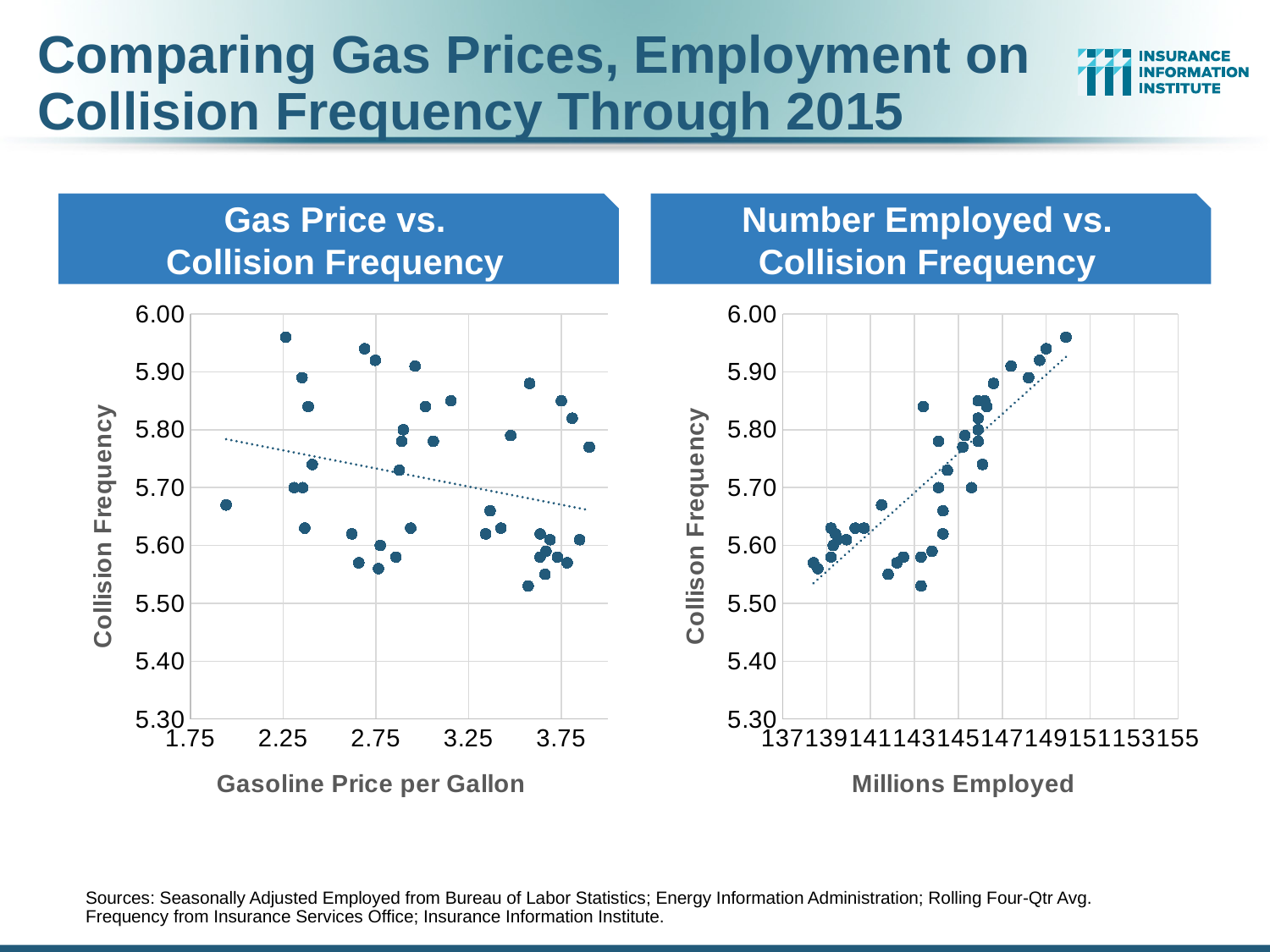
What is the x-axis title of the "Number Employed vs. Collision Frequency" chart? Millions Employed In the "Gas Price vs. Collision Frequency" chart, is the collision frequency for the point with the lowest gasoline price greater or less than 5.70? less In the "Gas Price vs. Collision Frequency" chart, is the highest collision frequency plotted greater or less than 5.90? greater In the "Gas Price vs. Collision Frequency" chart, does the dotted trend line rise or fall as gasoline price increases? Falls What kind of chart is the "Number Employed vs. Collision Frequency" chart? Scatter chart What is the x-axis title of the "Gas Price vs. Collision Frequency" chart? Gasoline Price per Gallon In the "Number Employed vs. Collision Frequency" chart, is the collision frequency for the point with the highest millions employed greater or less than 5.90? greater In the "Number Employed vs. Collision Frequency" chart, does the dotted trend line rise or fall as millions employed increases? Rises What kind of chart is the "Gas Price vs. Collision Frequency" chart? Scatter chart